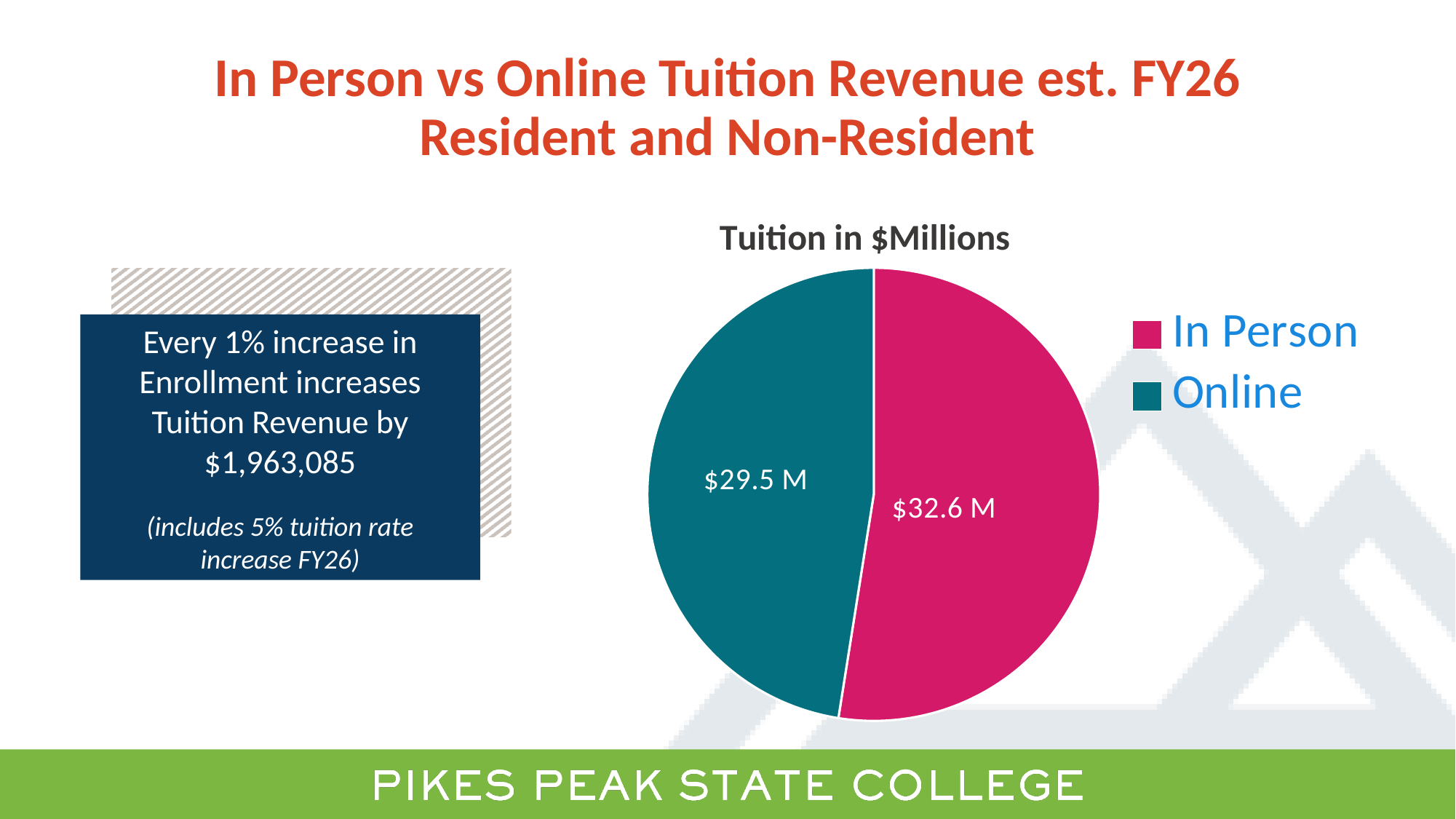
What is the combined total of the two slices in the pie chart? $62.1 M What colour represents Online in the pie chart? teal Which category has the larger tuition revenue in the pie chart? In Person What type of chart is shown on the slide? pie chart How many entries does the chart legend list? 2 How many slices does the pie chart have? 2 What is the tuition revenue value for Online in the pie chart? $29.5 M What is the title of the pie chart? Tuition in $Millions What is the difference between the In Person and Online tuition revenue values? $3.1 M Is the In Person value larger or smaller than the Online value? larger Which category has the smaller tuition revenue in the pie chart? Online What is the tuition revenue value for In Person in the pie chart? $32.6 M